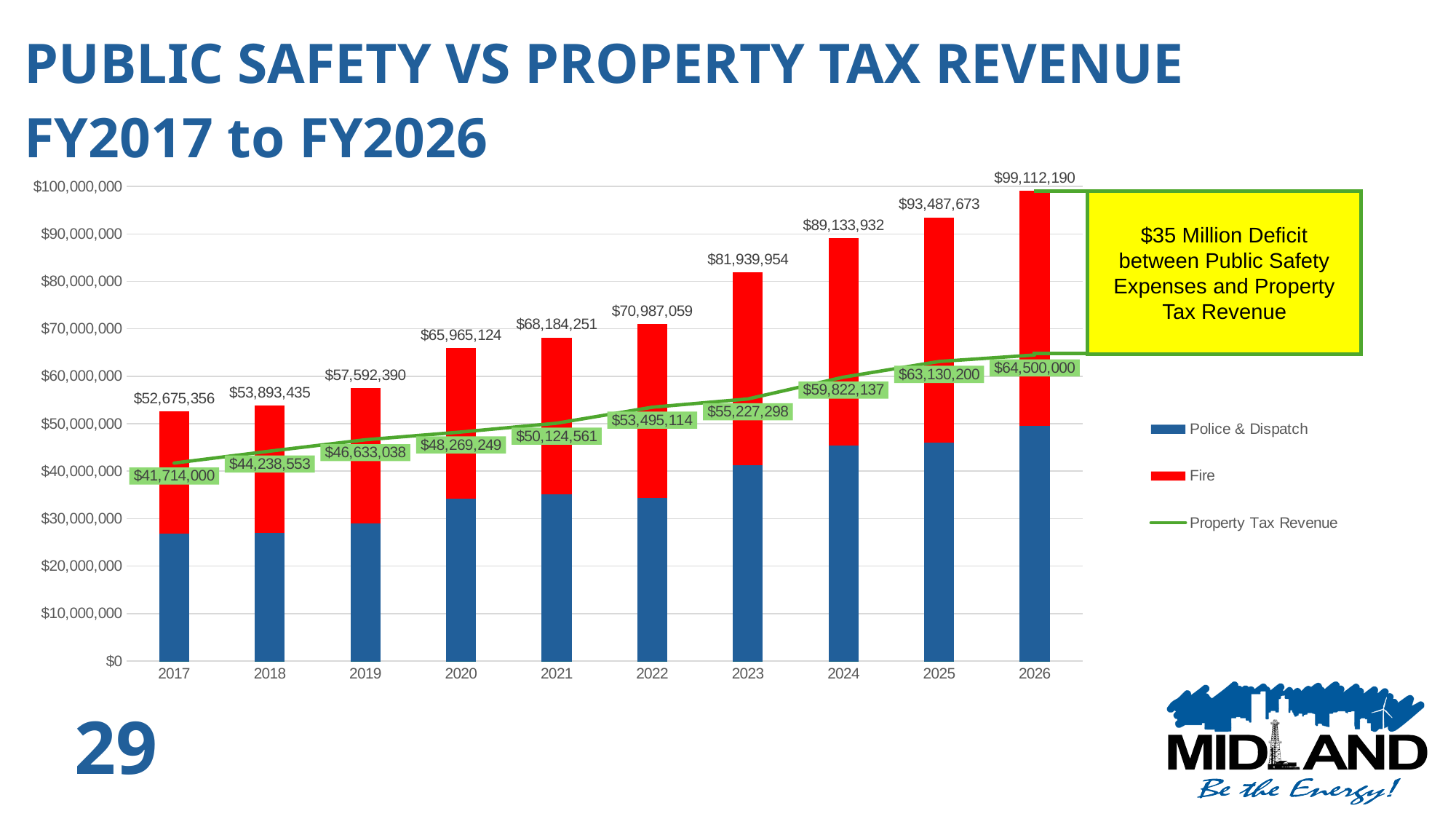
Which is larger, the total public safety expense in 2023 or the Property Tax Revenue in 2023? Total public safety expense in 2023 Do the total public safety expenses rise or fall from 2017 to 2026? rise Which year has the lowest Property Tax Revenue? 2017 What is the total public safety expense labeled for 2026? $99,112,190 Is the Police & Dispatch value for 2017 greater or less than $30,000,000? less What is the total public safety expense labeled for 2020? $65,965,124 What is the difference between the 2026 total public safety expense and the 2026 Property Tax Revenue? $34,612,190 What is the Property Tax Revenue value shown for 2017? $41,714,000 Which year has the highest total public safety expense? 2026 How many years are shown on the x axis? 10 What is the Property Tax Revenue value shown for 2024? $59,822,137 How many series does the legend list? 3